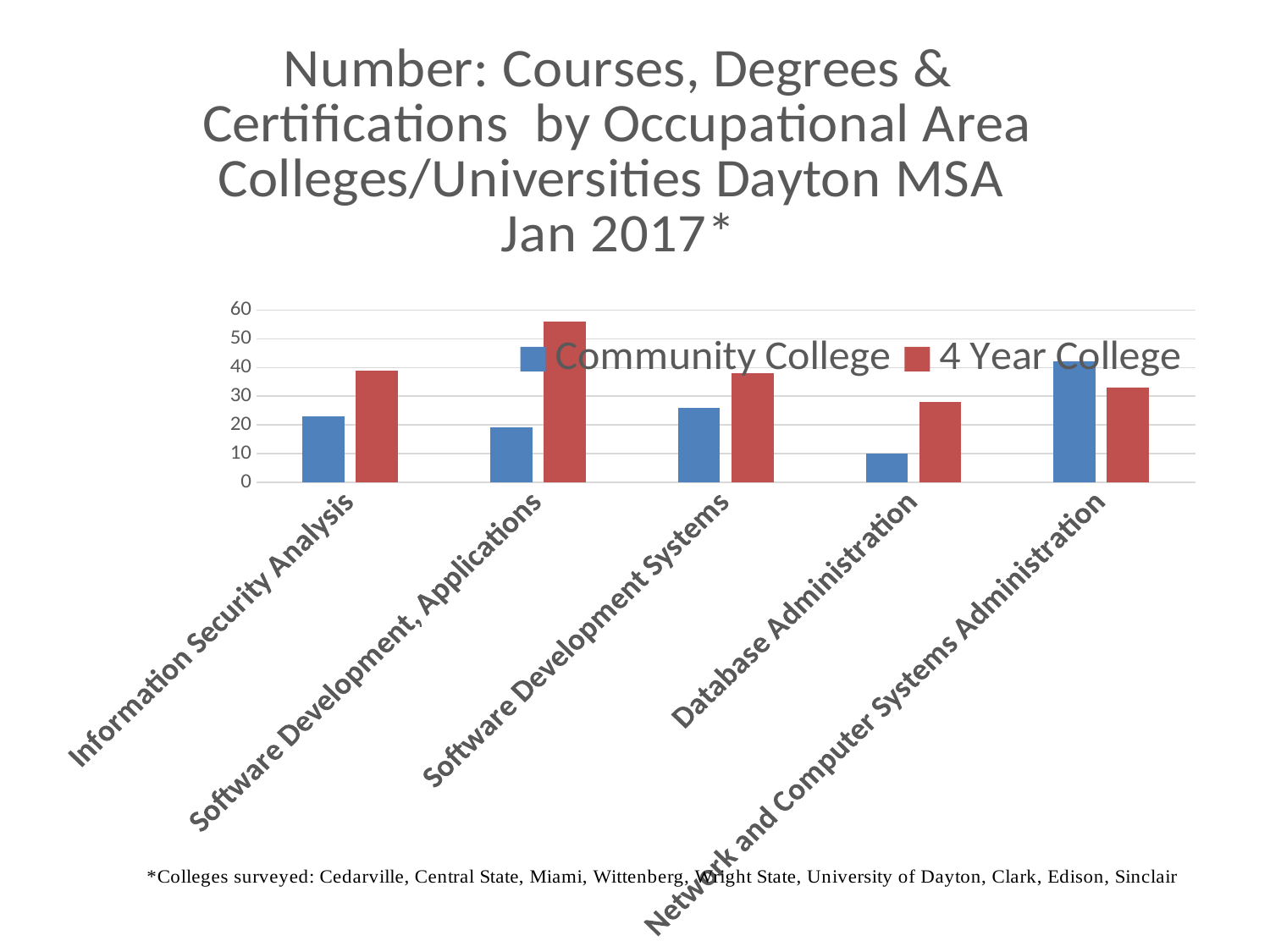
How many occupational area categories are shown on the x axis? 5 How many series does the legend list? 2 Is the Community College value for Information Security Analysis greater or less than 30? less Which occupational area has the lowest Community College value? Database Administration What kind of chart is shown on the slide? bar chart Is the 4 Year College value for Software Development, Applications greater or less than 50? greater For Information Security Analysis, which is larger: the Community College value or the 4 Year College value? 4 Year College For Network and Computer Systems Administration, which is larger: the Community College value or the 4 Year College value? Community College What colour are the 4 Year College bars? red Which occupational area has the highest Community College value? Network and Computer Systems Administration Is the 4 Year College value for Database Administration greater or less than 20? greater Which occupational area has the highest 4 Year College value? Software Development, Applications